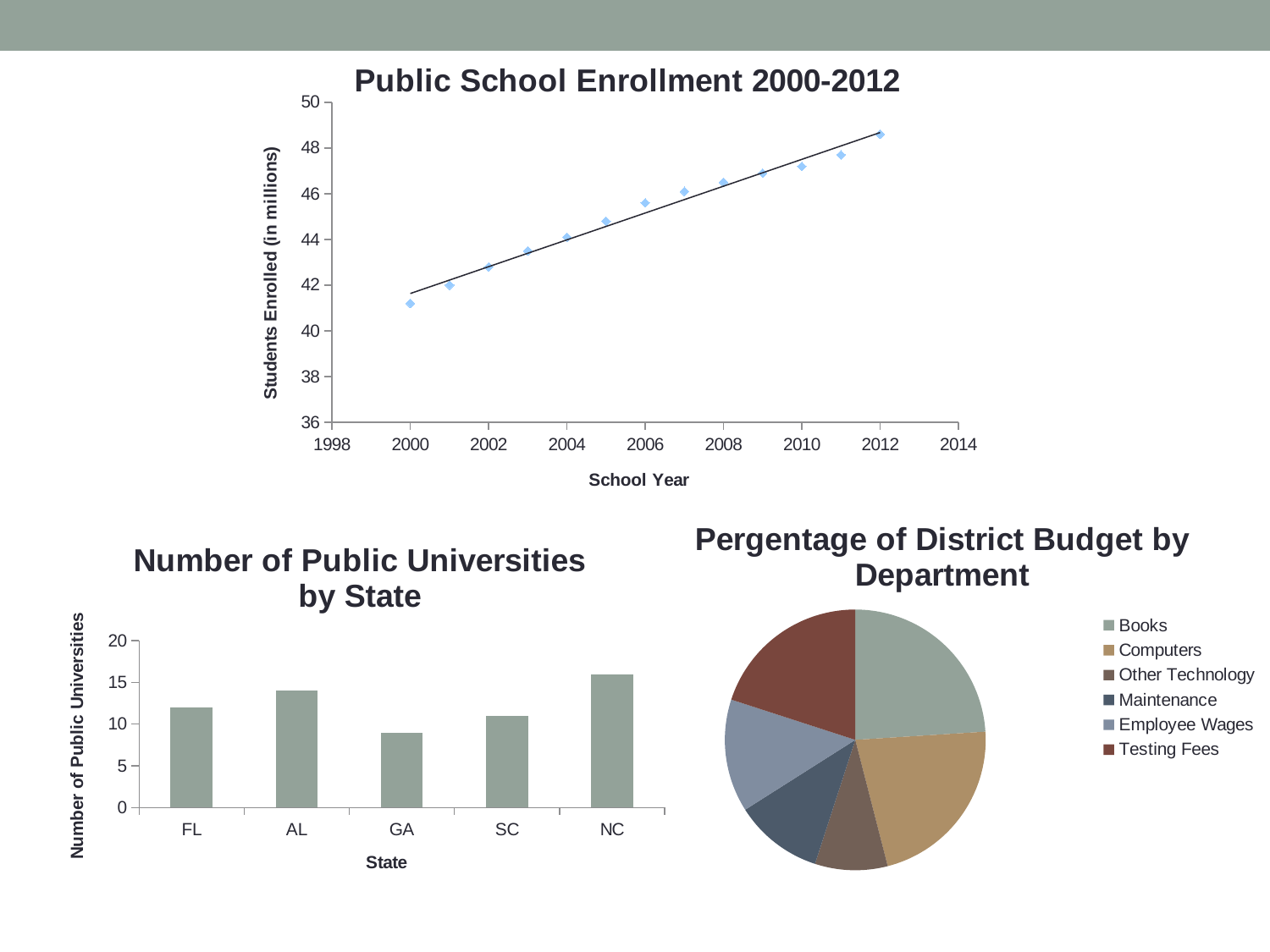
In the pie chart 'Pergentage of District Budget by Department', which department has the smallest slice? Other Technology In the 'Number of Public Universities by State' chart, which state has more public universities, AL or FL? AL In the 'Public School Enrollment 2000-2012' chart, is the value for 2012 greater or less than 48? greater How many states are shown in the 'Number of Public Universities by State' chart? 5 In the 'Number of Public Universities by State' chart, is the value for NC greater or less than 15? greater In the 'Public School Enrollment 2000-2012' chart, do the values rise or fall as the school year increases? rise What kind of chart is 'Number of Public Universities by State'? bar chart In the 'Number of Public Universities by State' chart, which state has the lowest number of public universities? GA In the 'Number of Public Universities by State' chart, is the value for GA greater or less than 10? less How many departments does the legend of the pie chart 'Pergentage of District Budget by Department' list? 6 In the 'Number of Public Universities by State' chart, which state has the highest number of public universities? NC